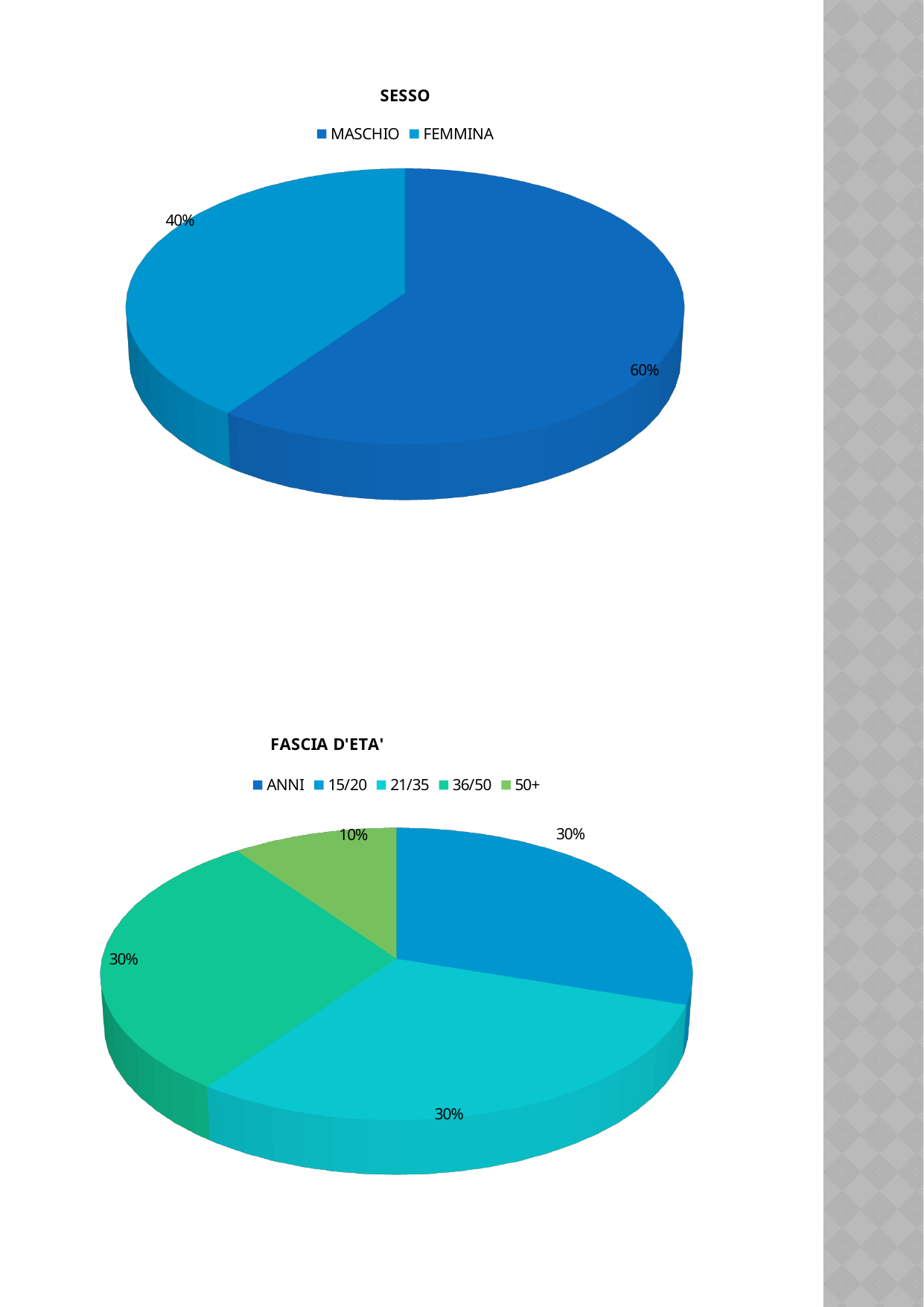
What kind of chart is the FASCIA D'ETA' chart? pie chart In the SESSO chart, what share does MASCHIO have? 60% In the FASCIA D'ETA' chart, which is larger, 36/50 or 50+? 36/50 What kind of chart is the SESSO chart? pie chart In the FASCIA D'ETA' chart, which category has the smallest slice? 50+ In the FASCIA D'ETA' chart, what share does the 50+ category have? 10% How many entries does the legend of the SESSO chart list? 2 In the SESSO chart, what is the difference between the MASCHIO and FEMMINA shares? 20% In the SESSO chart, what share does FEMMINA have? 40% In the SESSO chart, which category has the largest slice? MASCHIO How many entries does the legend of the FASCIA D'ETA' chart list? 5 In the SESSO chart, which is larger, MASCHIO or FEMMINA? MASCHIO